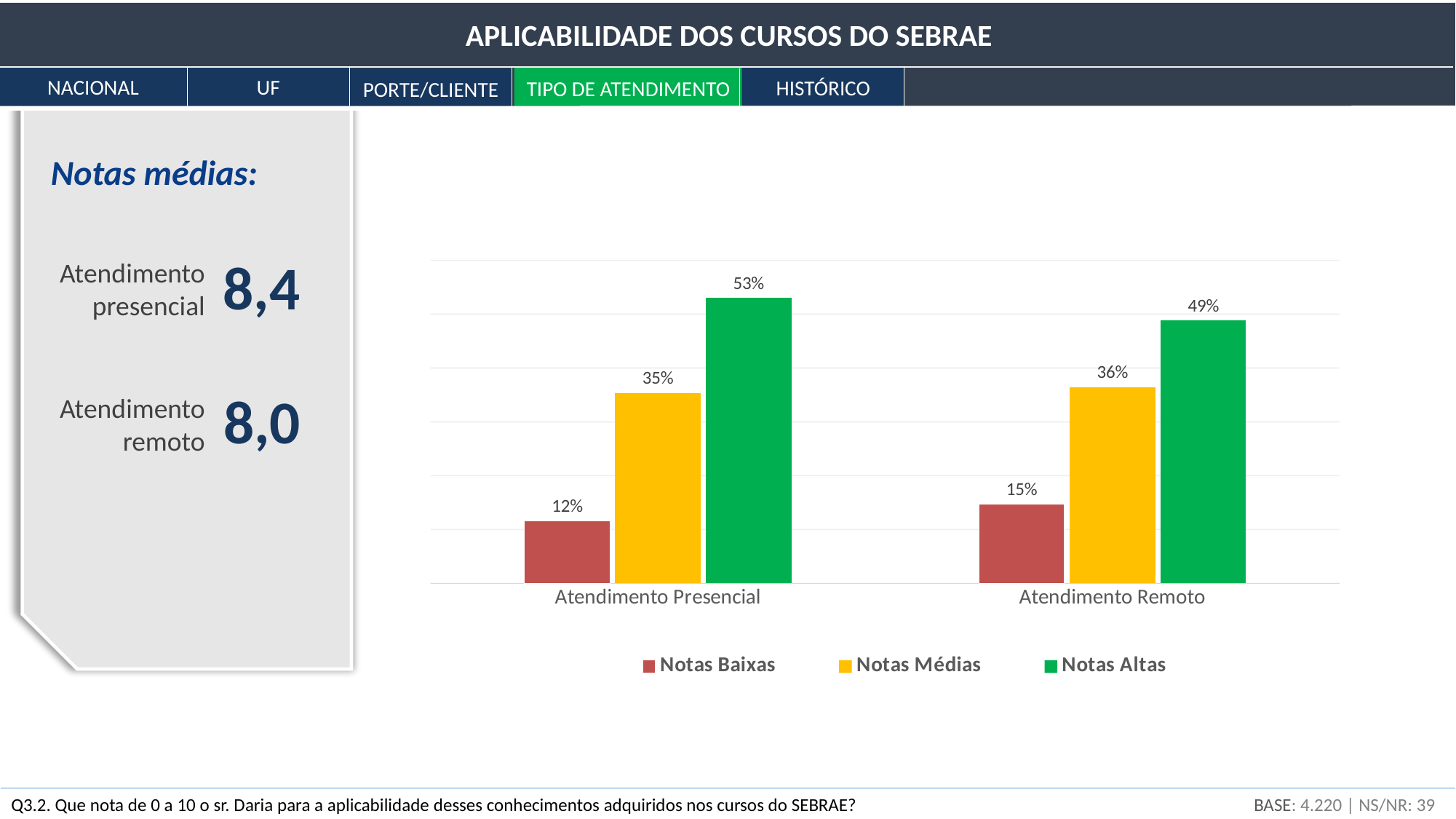
What is the value of Notas Baixas for Atendimento Remoto? 15% What is the value of Notas Médias for Atendimento Remoto? 36% How many categories are shown on the x axis of the chart? 2 What is the value of Notas Altas for Atendimento Presencial? 53% What is the value of Notas Médias for Atendimento Presencial? 35% What is the difference between Notas Altas for Atendimento Presencial and Notas Altas for Atendimento Remoto? 4% How many series does the chart legend list? 3 What kind of chart is shown on the slide? Bar chart Which series has the highest value for Atendimento Remoto? Notas Altas Which is larger: Notas Baixas for Atendimento Presencial or Notas Baixas for Atendimento Remoto? Atendimento Remoto Which series has the lowest value for Atendimento Presencial? Notas Baixas What colour are the Notas Altas bars in the chart? Green